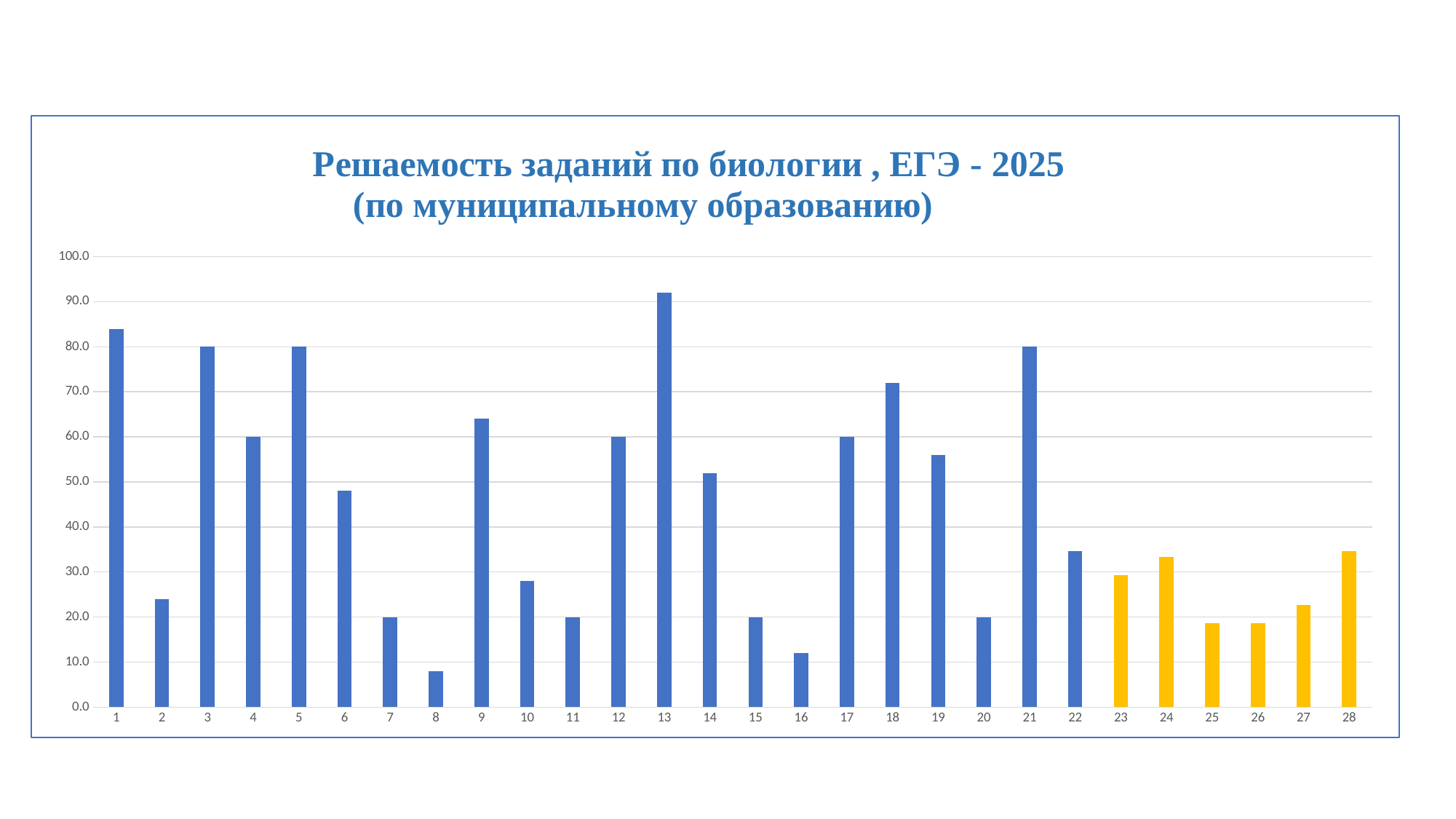
Which task has the highest value? 13 Which task has the lowest value? 8 Is the value for task 13 greater or less than 90? greater Which tasks are shown with yellow bars instead of blue? 23 to 28 Is the value for task 8 greater or less than 10? less Which is larger, the value for task 9 or the value for task 14? Task 9 How many categories (tasks) are plotted on the x axis? 28 What is the title of the chart? Решаемость заданий по биологии , ЕГЭ - 2025 (по муниципальному образованию) What kind of chart is shown on the slide? Bar chart What is the value for task 3? 80.0 What is the value for task 15? 20.0 What is the value for task 12? 60.0